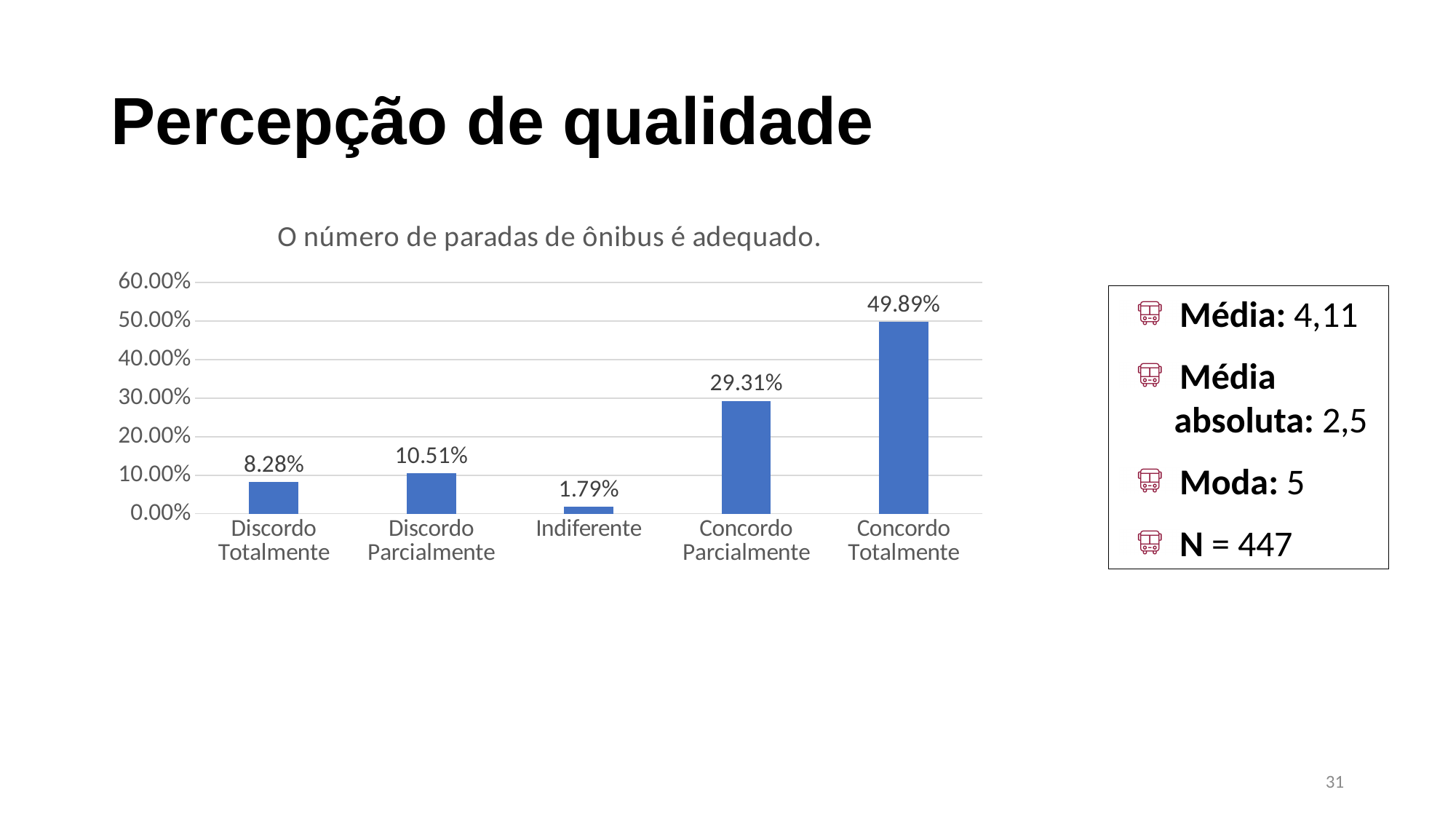
What is the title of the chart? O número de paradas de ônibus é adequado. Which is larger, Discordo Totalmente or Discordo Parcialmente? Discordo Parcialmente Which category has the lowest value? Indiferente Which category has the highest value? Concordo Totalmente Is the value for Concordo Parcialmente greater or less than 20.00%? greater How many categories are shown on the x axis? 5 What kind of chart is shown? bar chart What is the difference between Discordo Parcialmente and Discordo Totalmente? 2.23% What is the difference between Concordo Totalmente and Concordo Parcialmente? 20.58% What is the value for Concordo Totalmente? 49.89% What is the value for Discordo Parcialmente? 10.51% What is the value for Indiferente? 1.79%